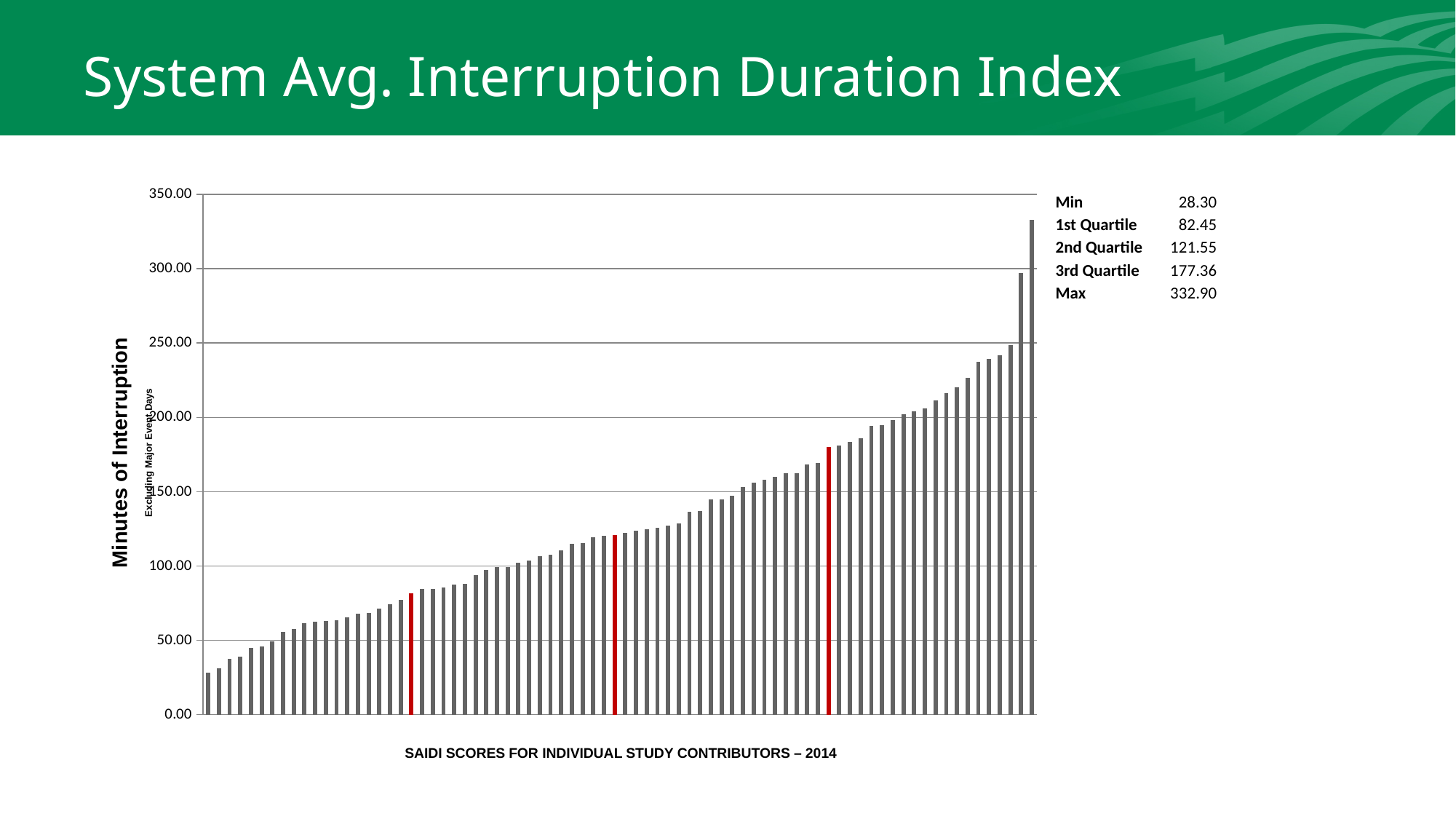
What is the difference between the Max and Min values listed next to the chart? 304.60 What is the Min value listed in the summary table next to the chart? 28.30 What is the title printed below the x axis of the chart? SAIDI SCORES FOR INDIVIDUAL STUDY CONTRIBUTORS – 2014 What is the Max value listed in the summary table next to the chart? 332.90 What is the 1st Quartile value listed next to the chart? 82.45 What is the 3rd Quartile value listed next to the chart? 177.36 What is the difference between the 3rd Quartile and 1st Quartile values listed next to the chart? 94.91 How many bars in the chart are highlighted in red? 3 Do the bar values rise or fall from left to right along the x axis? rise What is the 2nd Quartile value listed next to the chart? 121.55 Is the value of the tallest bar greater or less than 300? greater What kind of chart is shown on the slide? bar chart